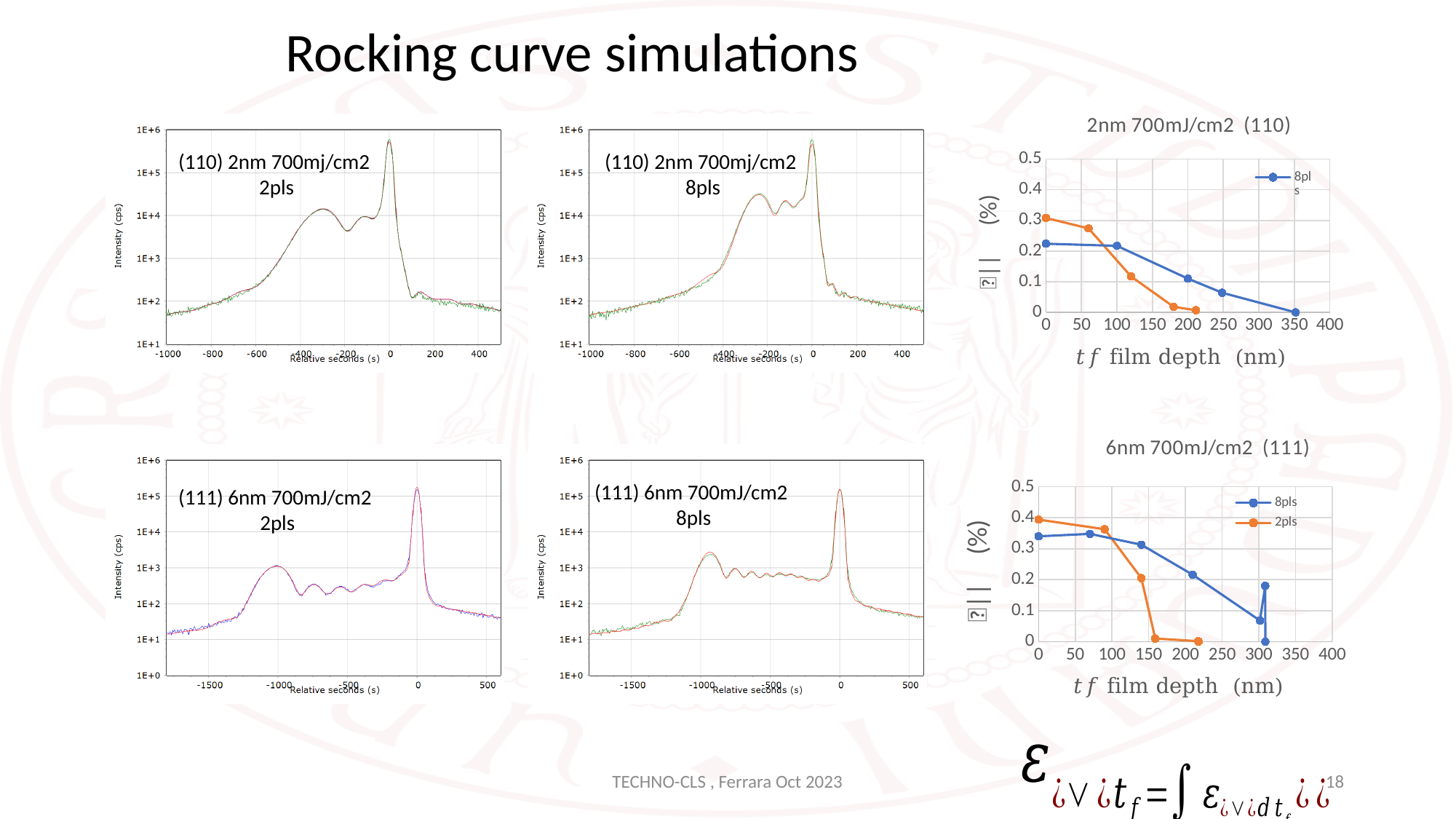
What kind of chart is the '6nm 700mJ/cm2 (111)' chart on the right of the slide? line chart What are the legend entries of the '6nm 700mJ/cm2 (111)' chart? 8pls and 2pls In the '6nm 700mJ/cm2 (111)' chart, do the 2pls values rise or fall as film depth increases? fall In the '2nm 700mJ/cm2 (110)' chart, do the 8pls values rise or fall as film depth increases? fall In the '6nm 700mJ/cm2 (111)' chart, is the 2pls value at 0 nm film depth greater or less than 0.3? greater In the '6nm 700mJ/cm2 (111)' chart, at 0 nm film depth, which series has the higher value, 8pls or 2pls? 2pls How many series does the legend of the '6nm 700mJ/cm2 (111)' chart list? 2 How many rocking curve intensity plots are shown on the left side of the slide? 4 What is the highest tick value on the x axis of the '2nm 700mJ/cm2 (110)' chart? 400 In the '2nm 700mJ/cm2 (110)' chart, is the 8pls value at 250 nm film depth greater or less than 0.1? less In the '6nm 700mJ/cm2 (111)' chart, is the 8pls value at 200 nm film depth greater or less than 0.3? less